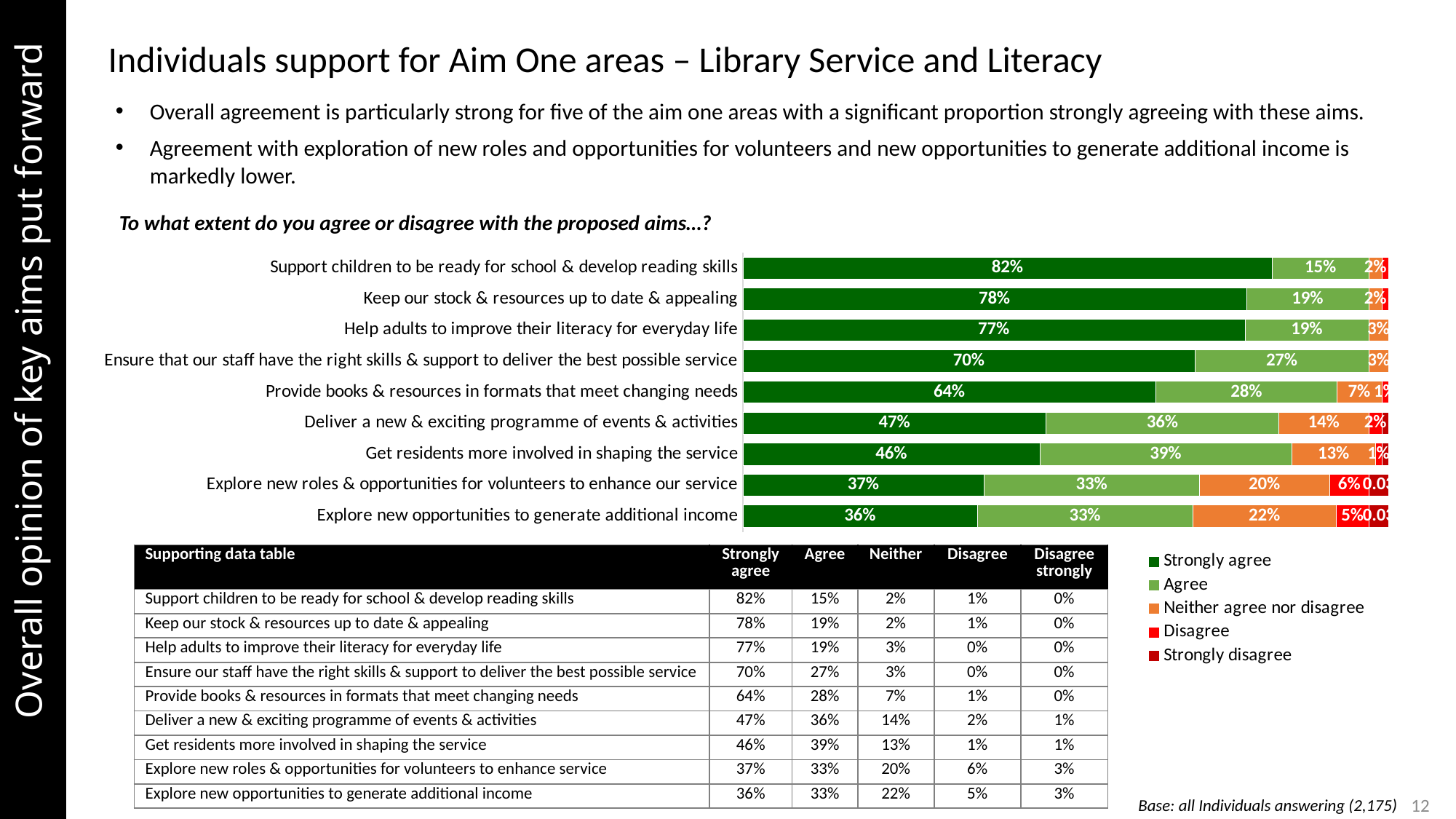
What is the difference between the 'Strongly agree' values for 'Keep our stock & resources up to date & appealing' and 'Provide books & resources in formats that meet changing needs'? 14% Which has a larger 'Agree' value: 'Get residents more involved in shaping the service' or 'Deliver a new & exciting programme of events & activities'? Get residents more involved in shaping the service Which aim has the highest 'Strongly agree' value? Support children to be ready for school & develop reading skills How many aims (categories) are shown in the chart? 9 What kind of chart is shown on the slide? Stacked bar chart Which aim has the lowest 'Strongly agree' value? Explore new opportunities to generate additional income How many series does the legend list? 5 What is the 'Neither agree nor disagree' value for 'Explore new opportunities to generate additional income'? 22% What is the 'Neither agree nor disagree' value for 'Deliver a new & exciting programme of events & activities'? 14% What is the 'Strongly agree' value for 'Support children to be ready for school & develop reading skills'? 82% What is the 'Agree' value for 'Ensure that our staff have the right skills & support to deliver the best possible service'? 27% Which colour represents 'Strongly agree' in the legend? Dark green